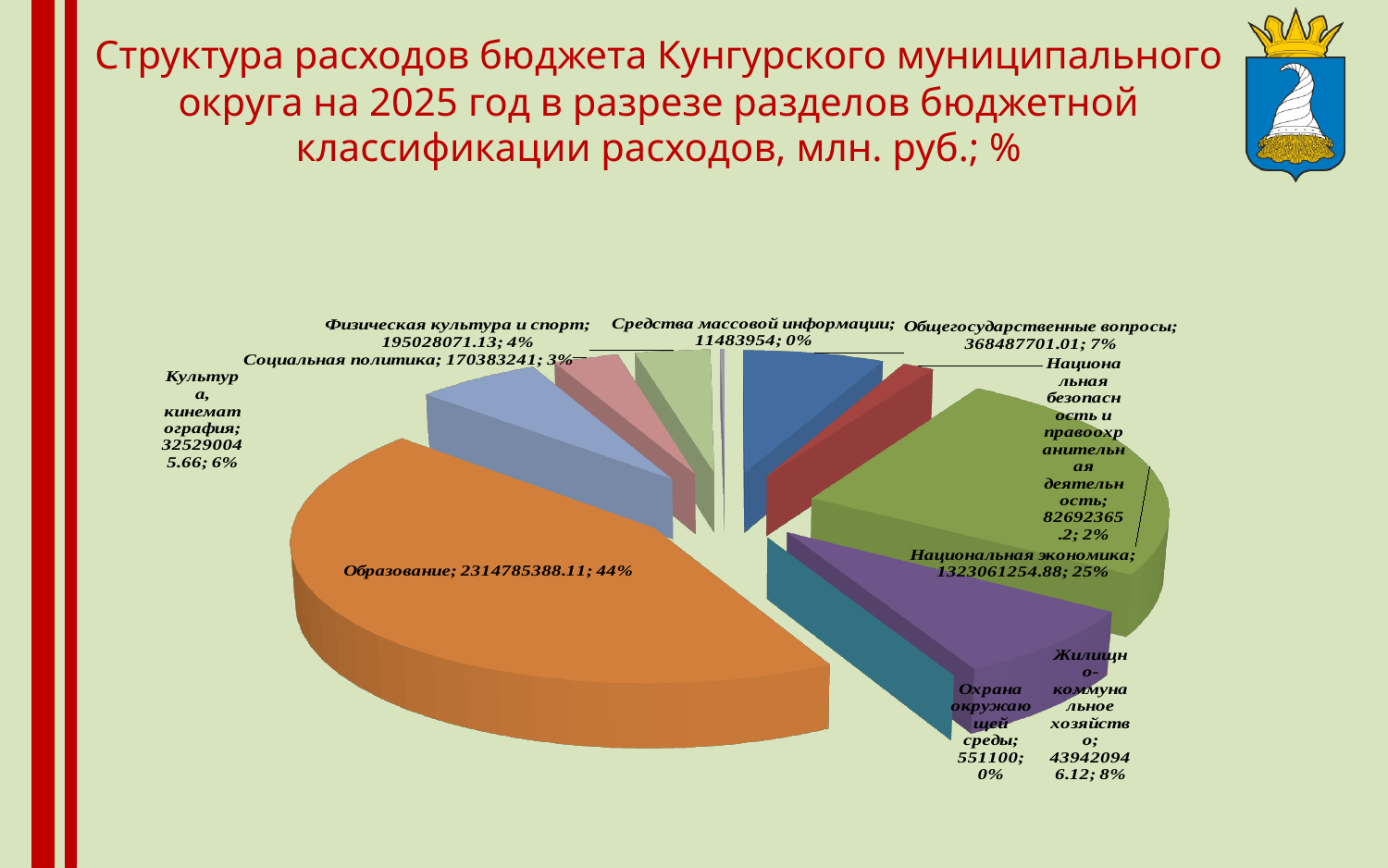
What is the difference between the values for Образование and Национальная экономика? 991724133.23 What share of the pie does Жилищно-коммунальное хозяйство represent? 8% Which is larger: Национальная экономика or Жилищно-коммунальное хозяйство? Национальная экономика How many categories (slices) does the pie chart show? 10 Which category has the largest value? Образование What is the difference between the values for Общегосударственные вопросы and Социальная политика? 198104460.01 What is the value for Общегосударственные вопросы? 368487701.01 What is the value for Национальная экономика? 1323061254.88 What is the value for Образование? 2314785388.11 Which category has the smallest value? Охрана окружающей среды What kind of chart is shown on the slide? Pie chart What share of the pie does Образование represent? 44%